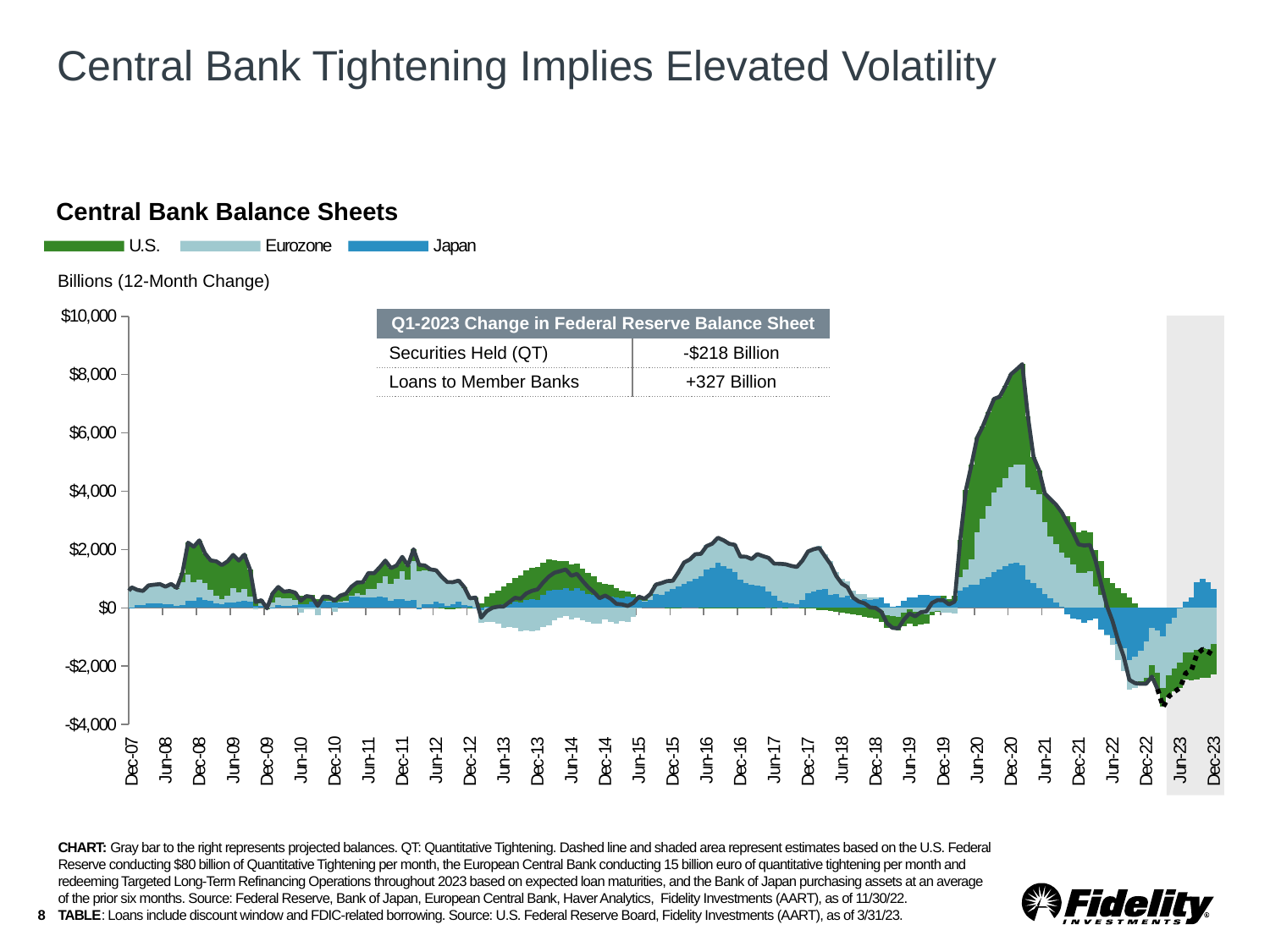
In the 'Central Bank Balance Sheets' chart, is the total 12-month change at Dec-20 greater or less than $6,000? greater Which series are listed in the legend of the 'Central Bank Balance Sheets' chart? U.S., Eurozone, Japan In the 'Central Bank Balance Sheets' chart, is the total 12-month change at Jun-16 greater or less than $1,000? greater In the inset table 'Q1-2023 Change in Federal Reserve Balance Sheet', what is the value for Loans to Member Banks? +327 Billion In the inset table 'Q1-2023 Change in Federal Reserve Balance Sheet', what is the value for Securities Held (QT)? -$218 Billion How many series does the legend of the 'Central Bank Balance Sheets' chart list? 3 In the 'Central Bank Balance Sheets' chart, what does the gray bar on the right represent? Projected balances What kind of chart is 'Central Bank Balance Sheets'? Stacked bar chart with a line (combination bar and line chart) How many date labels are shown on the x axis of the 'Central Bank Balance Sheets' chart? 33 In the 'Central Bank Balance Sheets' chart, is the total 12-month change at Dec-08 greater or less than $4,000? less In the 'Central Bank Balance Sheets' chart, does the total 12-month change rise or fall between Dec-20 and Dec-22? Fall